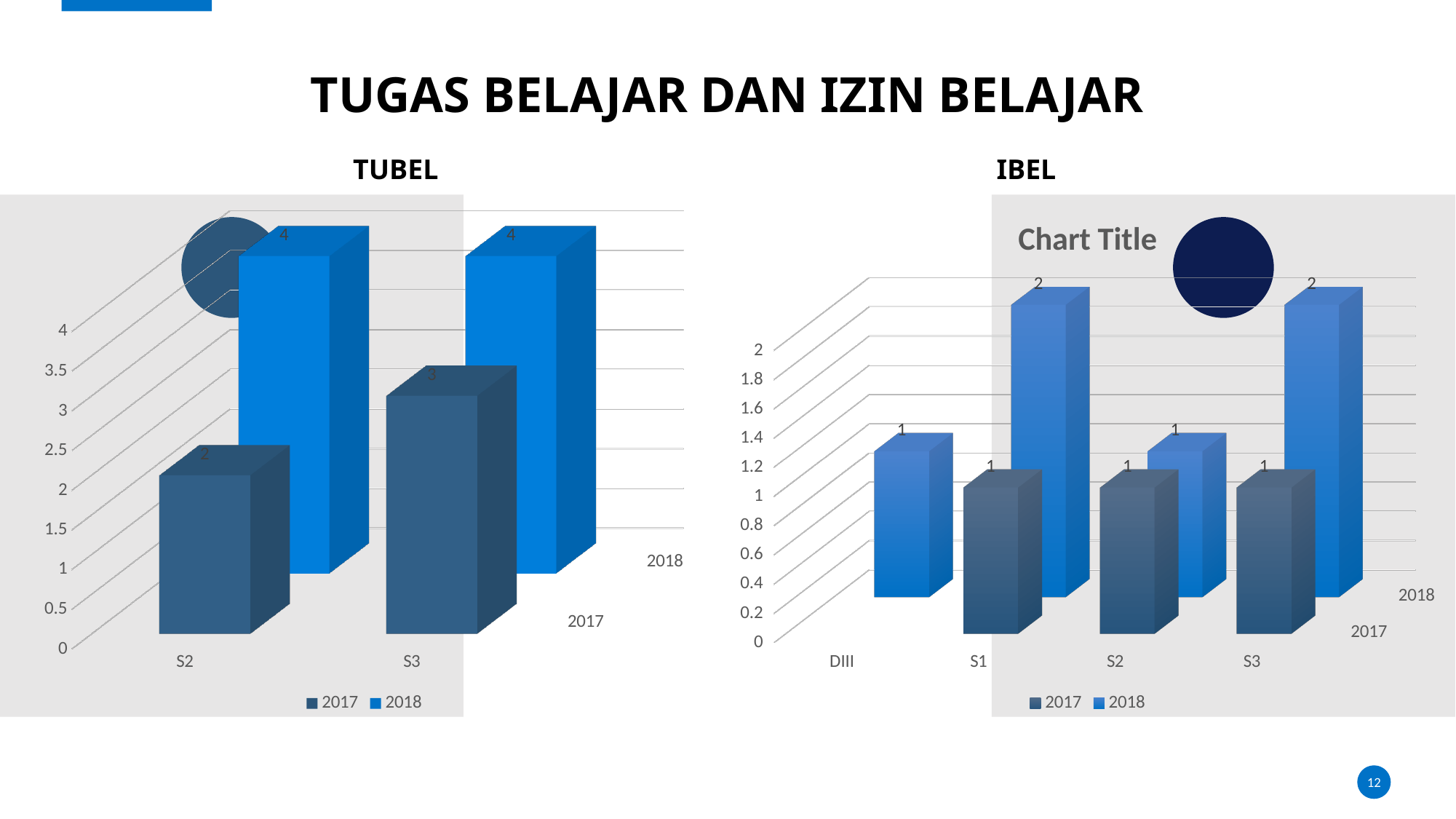
In the TUBEL chart, what is the value for S3 in 2018? 4 In the IBEL chart, how many categories are shown on the x axis? 4 In the IBEL chart, what is the value for S1 in 2018? 2 In the TUBEL chart, what is the difference between the 2018 and 2017 values for S2? 2 In the IBEL chart, what is the value for S2 in 2018? 1 In the TUBEL chart, which category has the higher 2017 value, S2 or S3? S3 How many series does the legend of the IBEL chart list? 2 In the TUBEL chart, how many categories are shown on the x axis? 2 In the TUBEL chart, what is the value for S3 in 2017? 3 What kind of chart is the TUBEL chart? Bar chart In the TUBEL chart, what is the value for S2 in 2017? 2 In the IBEL chart, what is the value for DIII in 2018? 1